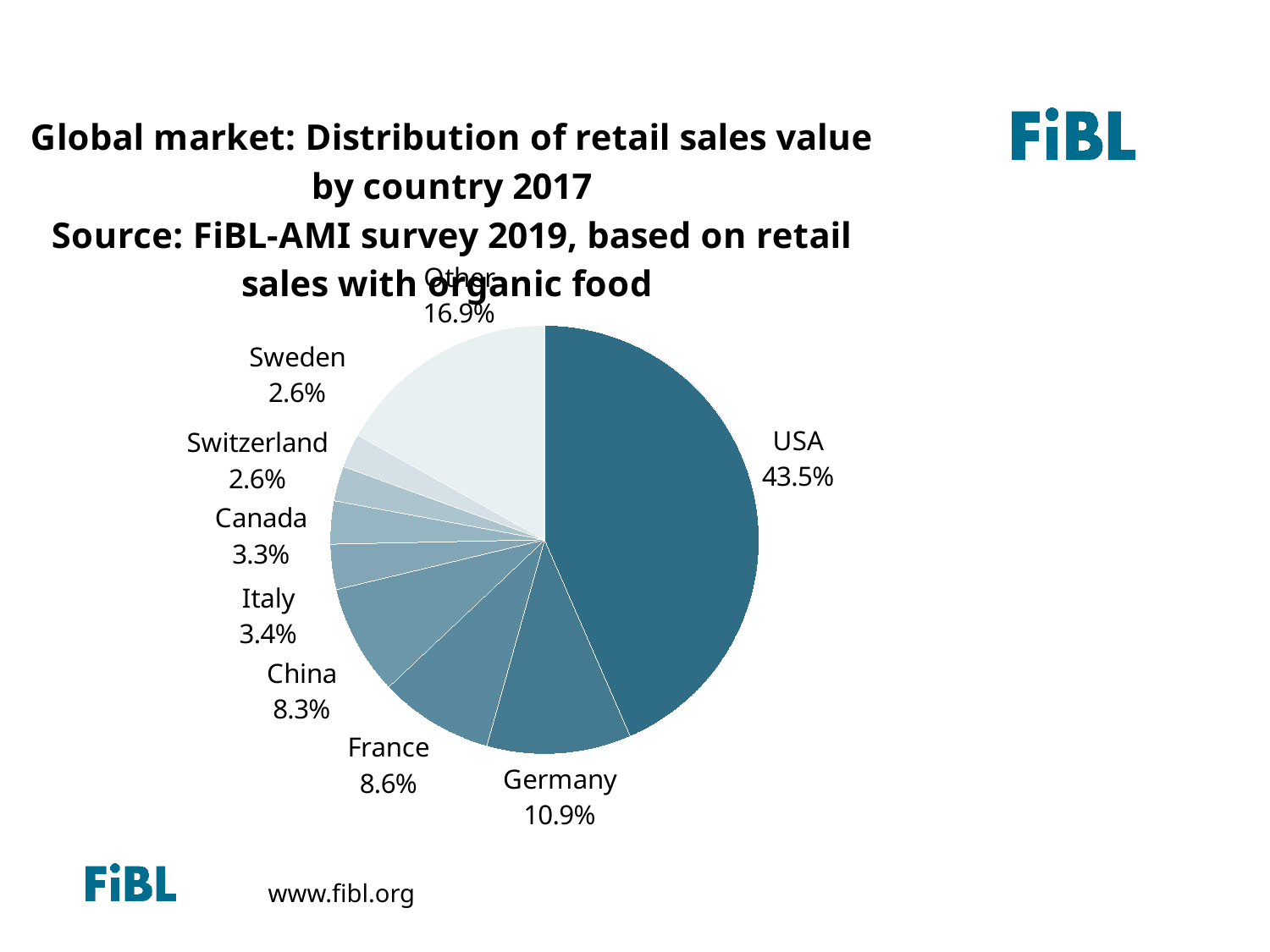
Which country has the largest slice of the pie chart? USA What is the difference between Germany's share and France's share? 2.3% What is the value shown for China? 8.3% What year does the chart title say the distribution refers to? 2017 Which has a larger share, France or China? France What share is labelled for the 'Other' slice? 16.9% What kind of chart is shown on the slide? Pie chart What percentage is shown for Germany? 10.9% How many slices does the pie chart have? 9 What is the difference in percentage points between the USA and Germany? 32.6% What share of the global retail sales value does the USA hold in the pie chart? 43.5% Which has a larger share, Germany or the 'Other' slice? Other